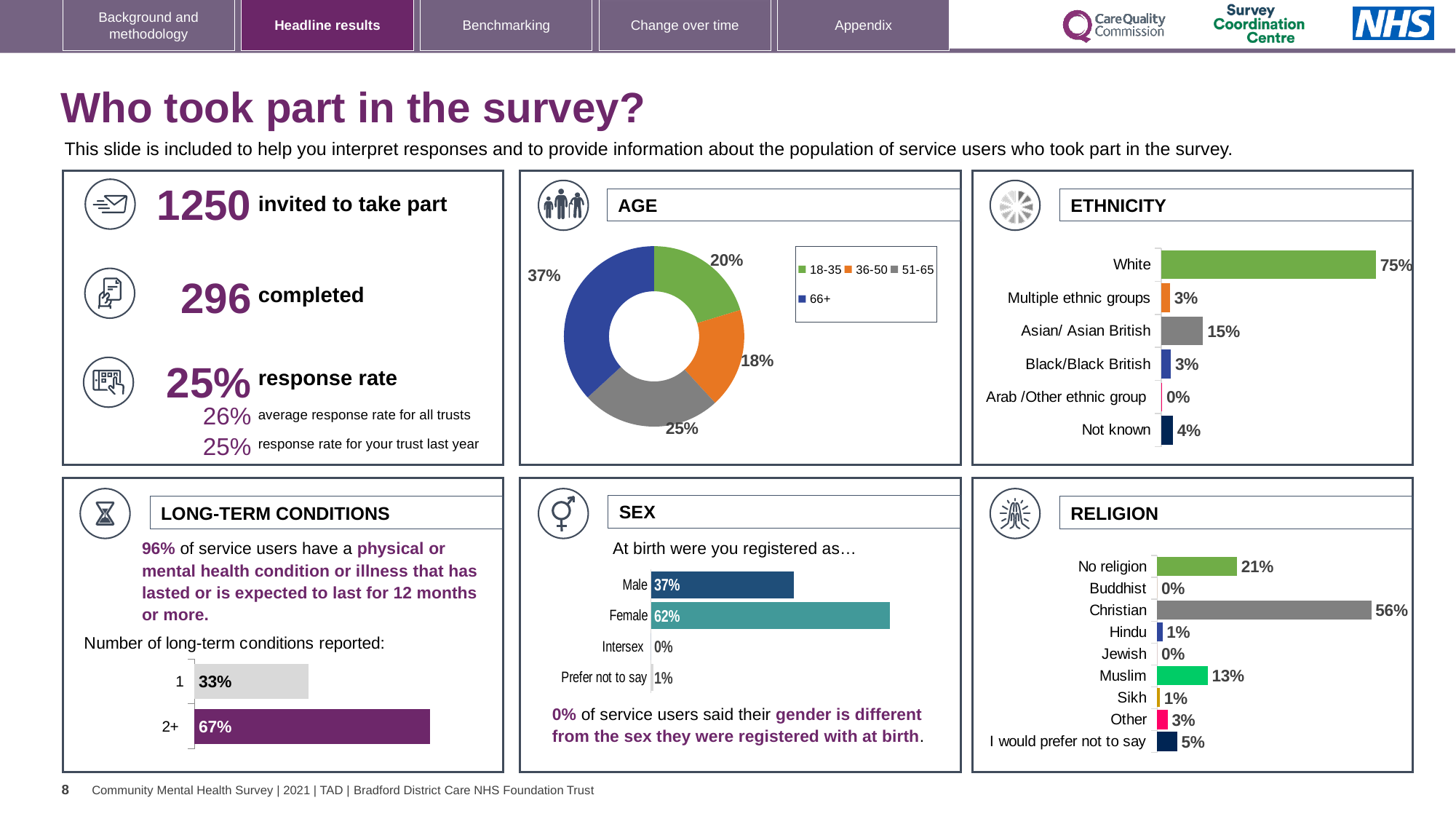
In the AGE chart, what share of respondents are aged 66+? 37% In the SEX chart, which is larger, Male or Female? Female What kind of chart is the AGE chart? Donut chart In the ETHNICITY chart, what is the difference between White and Asian/ Asian British? 60% In the AGE chart, which age group has the smallest share? 36-50 In the SEX chart, what is the value for Prefer not to say? 1% In the LONG-TERM CONDITIONS chart, what percentage reported 2+ conditions? 67% In the ETHNICITY chart, which category has the highest value? White How many age groups does the legend of the AGE chart list? 4 In the RELIGION chart, which category has the highest value? Christian How many categories are shown in the RELIGION chart? 9 In the ETHNICITY chart, what is the value for Asian/ Asian British? 15%